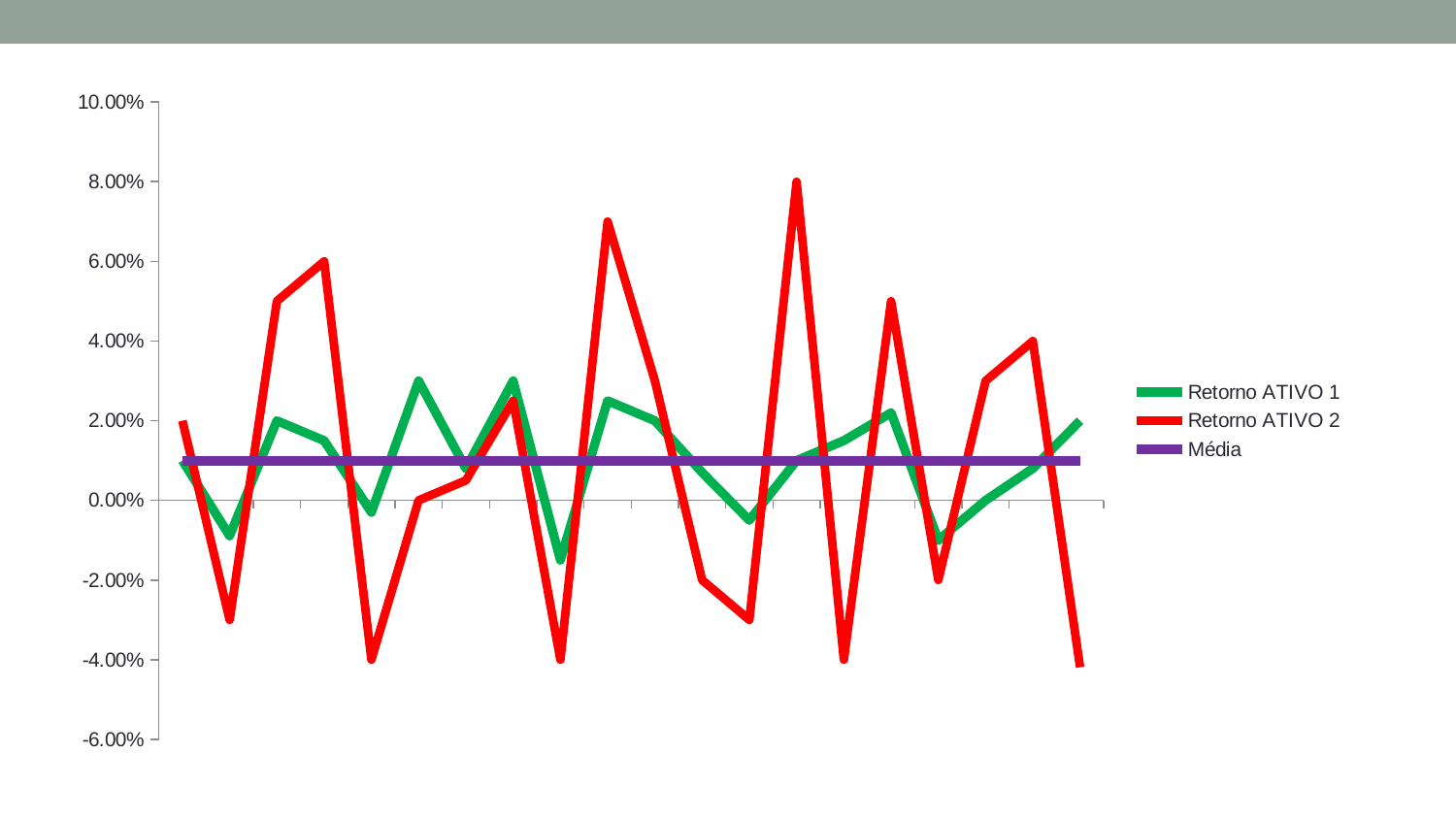
Is the value of the Média line greater or less than 0.00%? greater Is the highest value of Retorno ATIVO 2 greater or less than 6.00%? greater How many series does the legend list? 3 Is the highest value of Retorno ATIVO 1 greater or less than 4.00%? less Which colour is used for the Retorno ATIVO 2 series? red What kind of chart is shown on the slide? line chart Which series reaches the highest value on the chart? Retorno ATIVO 2 Which series reaches the lowest value on the chart? Retorno ATIVO 2 What are the names of the series listed in the legend? Retorno ATIVO 1, Retorno ATIVO 2, Média Which series shows larger swings along the x axis, Retorno ATIVO 1 or Retorno ATIVO 2? Retorno ATIVO 2